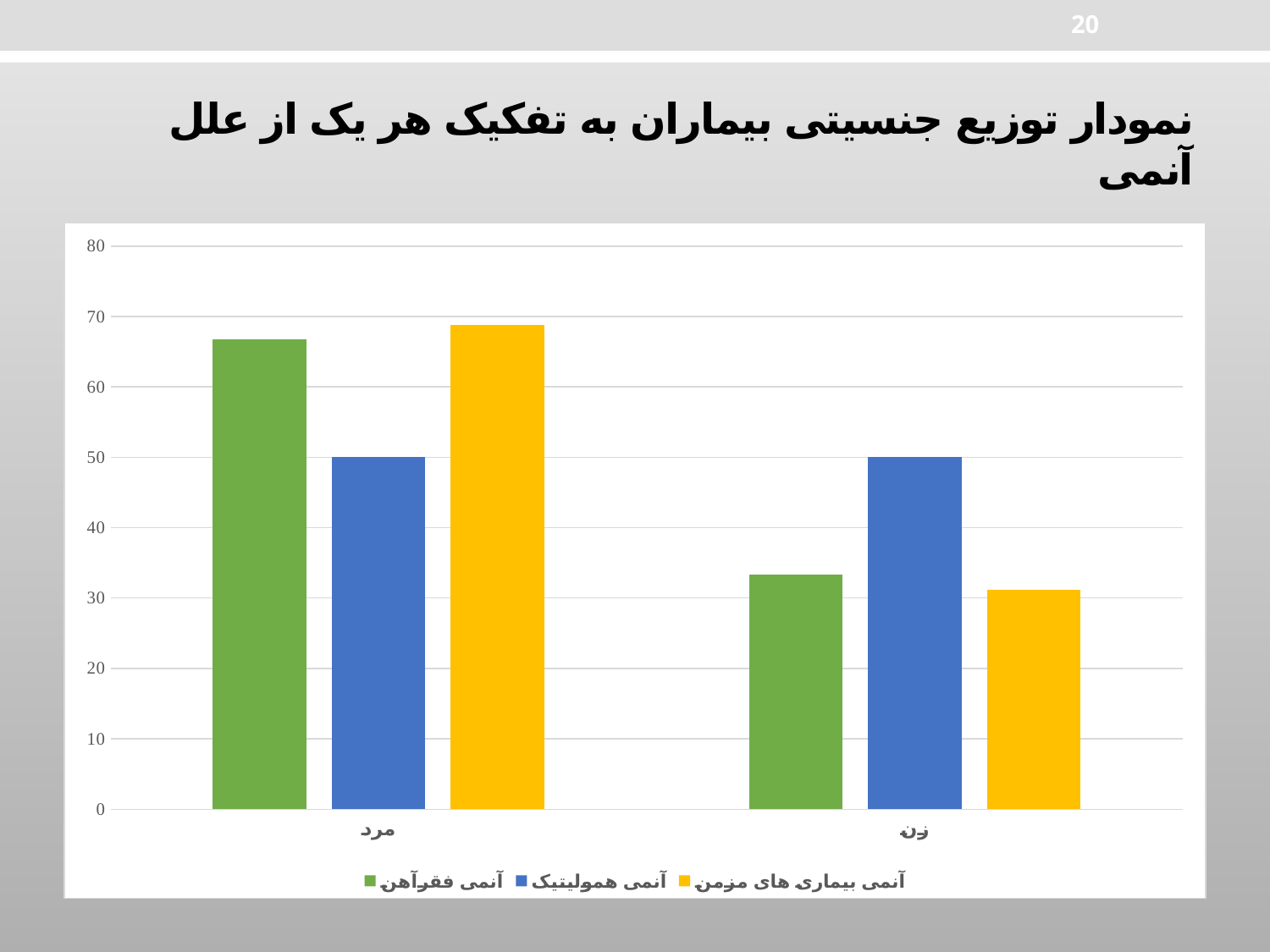
What is the value of آنمی همولیتیک for زن? 50 Is the value of آنمی فقرآهن for زن greater or less than 30? greater Is the value of آنمی بیماری های مزمن for زن greater or less than 40? less What is the value of آنمی همولیتیک for مرد? 50 How many categories are shown on the x axis? 2 Which series is shown in blue in the legend? آنمی همولیتیک Which is larger for زن: آنمی همولیتیک or آنمی فقرآهن? آنمی همولیتیک How many series does the legend list? 3 Which category has the higher value for آنمی فقرآهن: مرد or زن? مرد What kind of chart is shown on the slide? bar chart Is the value of آنمی فقرآهن for مرد greater or less than 60? greater